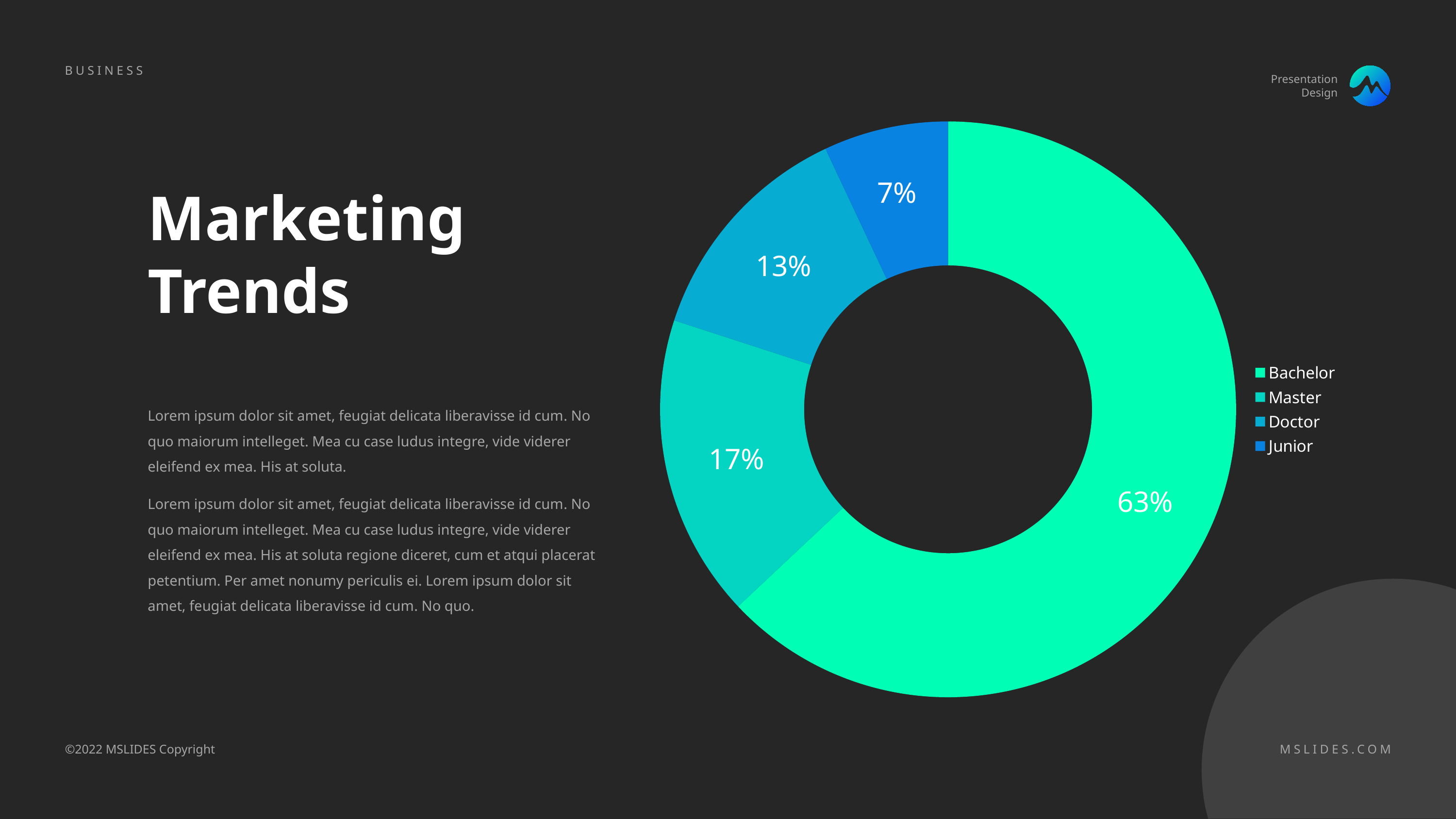
What is the difference in percentage points between the Bachelor and Master slices? 46 Which slice is larger, Master or Doctor? Master Which category has the largest slice in the chart? Bachelor What is the difference in percentage points between the Doctor and Junior slices? 6 Which category has the smallest slice in the chart? Junior What share of the doughnut chart does Doctor hold? 13% What share of the doughnut chart does Bachelor hold? 63% What share of the doughnut chart does Junior hold? 7% Which legend entry is shown in dark blue? Junior How many categories are shown in the chart? 4 What type of chart is shown on the slide? Doughnut chart What share of the doughnut chart does Master hold? 17%